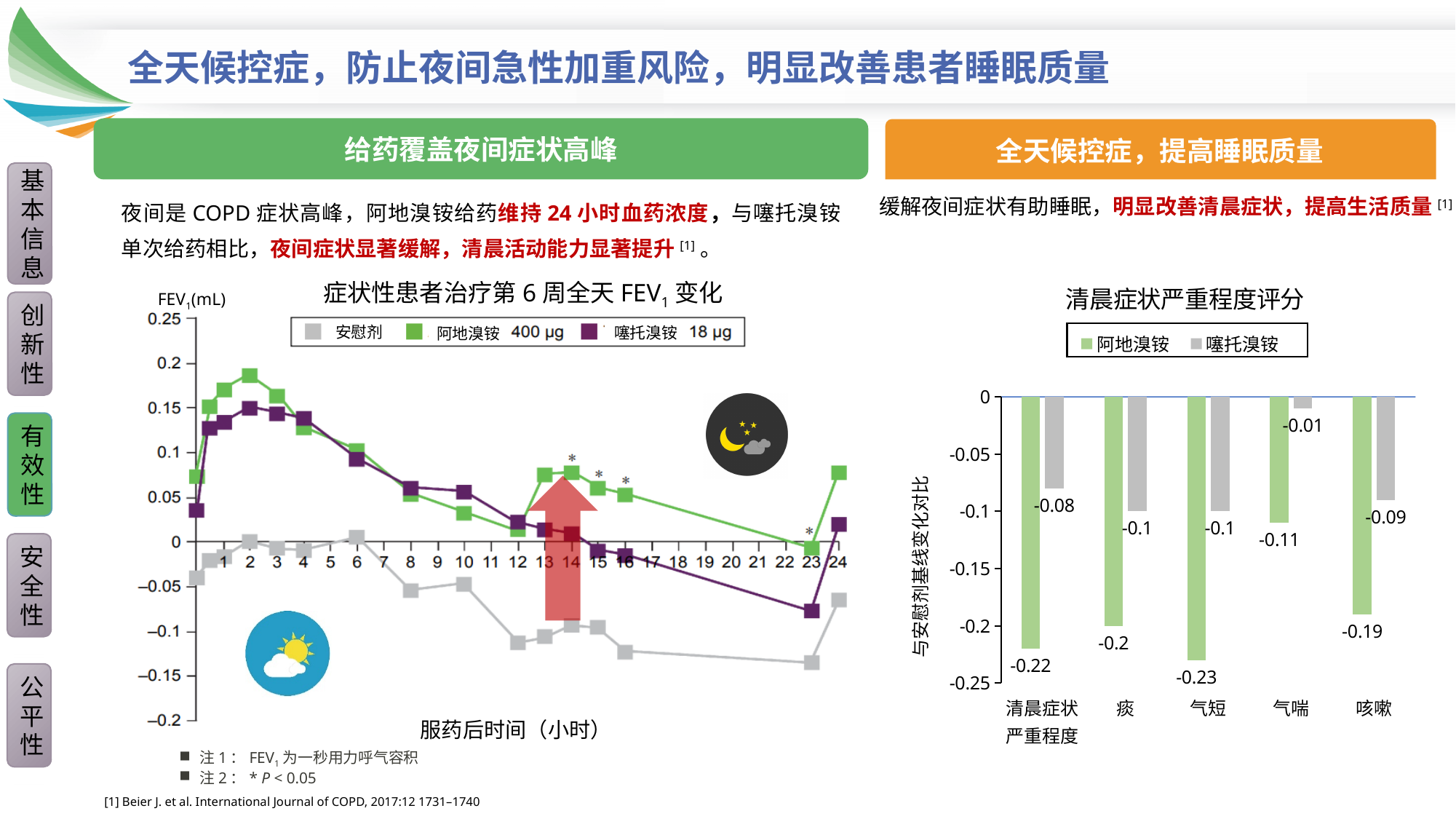
In the bar chart titled 清晨症状严重程度评分, which series has the larger (less negative) value for 痰, 阿地溴铵 or 噻托溴铵? 噻托溴铵 In the bar chart titled 清晨症状严重程度评分, what is the value for 阿地溴铵 in the 气短 category? -0.23 What kind of chart is the left chart titled 症状性患者治疗第6周全天FEV1变化? line chart In the left line chart titled 症状性患者治疗第6周全天FEV1变化, is the value for 阿地溴铵 400 µg at hour 2 greater or less than 0.15? greater How many series does the legend of the bar chart titled 清晨症状严重程度评分 list? 2 How many series does the legend of the left line chart titled 症状性患者治疗第6周全天FEV1变化 list? 3 In the bar chart titled 清晨症状严重程度评分, what is the value for 噻托溴铵 in the 气喘 category? -0.01 In the bar chart titled 清晨症状严重程度评分, which category has the highest (least negative) value for 噻托溴铵? 气喘 In the bar chart titled 清晨症状严重程度评分, which category has the lowest (most negative) value for 阿地溴铵? 气短 How many categories are shown on the x axis of the bar chart titled 清晨症状严重程度评分? 5 In the bar chart titled 清晨症状严重程度评分, what is the difference between the 阿地溴铵 and 噻托溴铵 values for 清晨症状严重程度? 0.14 In the bar chart titled 清晨症状严重程度评分, what is the value for 阿地溴铵 in the 咳嗽 category? -0.19